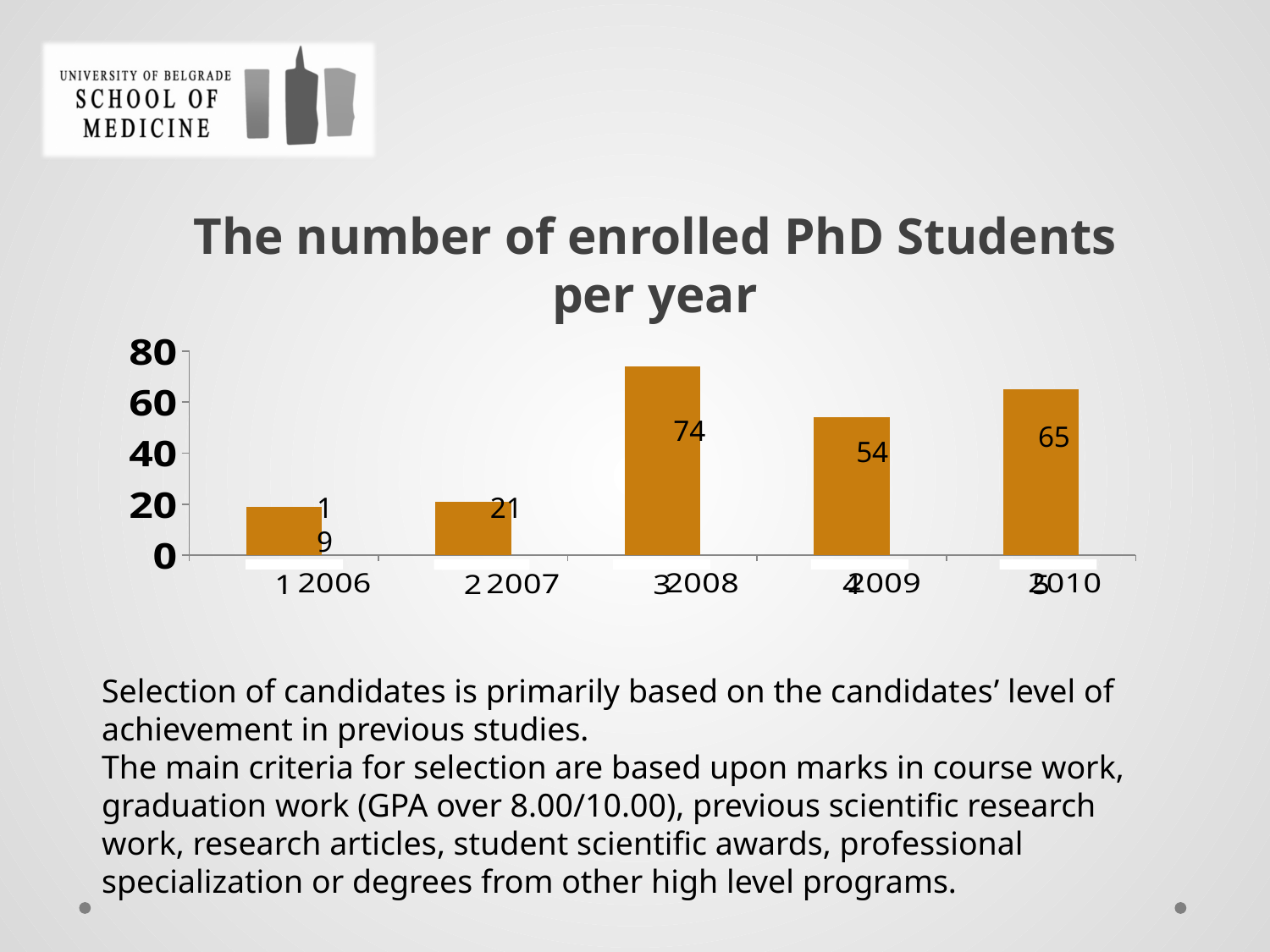
Which year had more enrolled PhD students, 2009 or 2010? 2010 What is the number of enrolled PhD students in 2008? 74 How many more PhD students were enrolled in 2008 than in 2009? 20 Which year has the highest number of enrolled PhD students? 2008 What is the number of enrolled PhD students in 2010? 65 How many years are shown on the chart? 5 What is the difference between the number of enrolled PhD students in 2010 and in 2009? 11 Is the number of enrolled PhD students in 2006 greater or less than 40? less Which year has the lowest number of enrolled PhD students? 2006 What is the number of enrolled PhD students in 2007? 21 What is the number of enrolled PhD students in 2009? 54 What type of chart is shown on the slide? bar chart